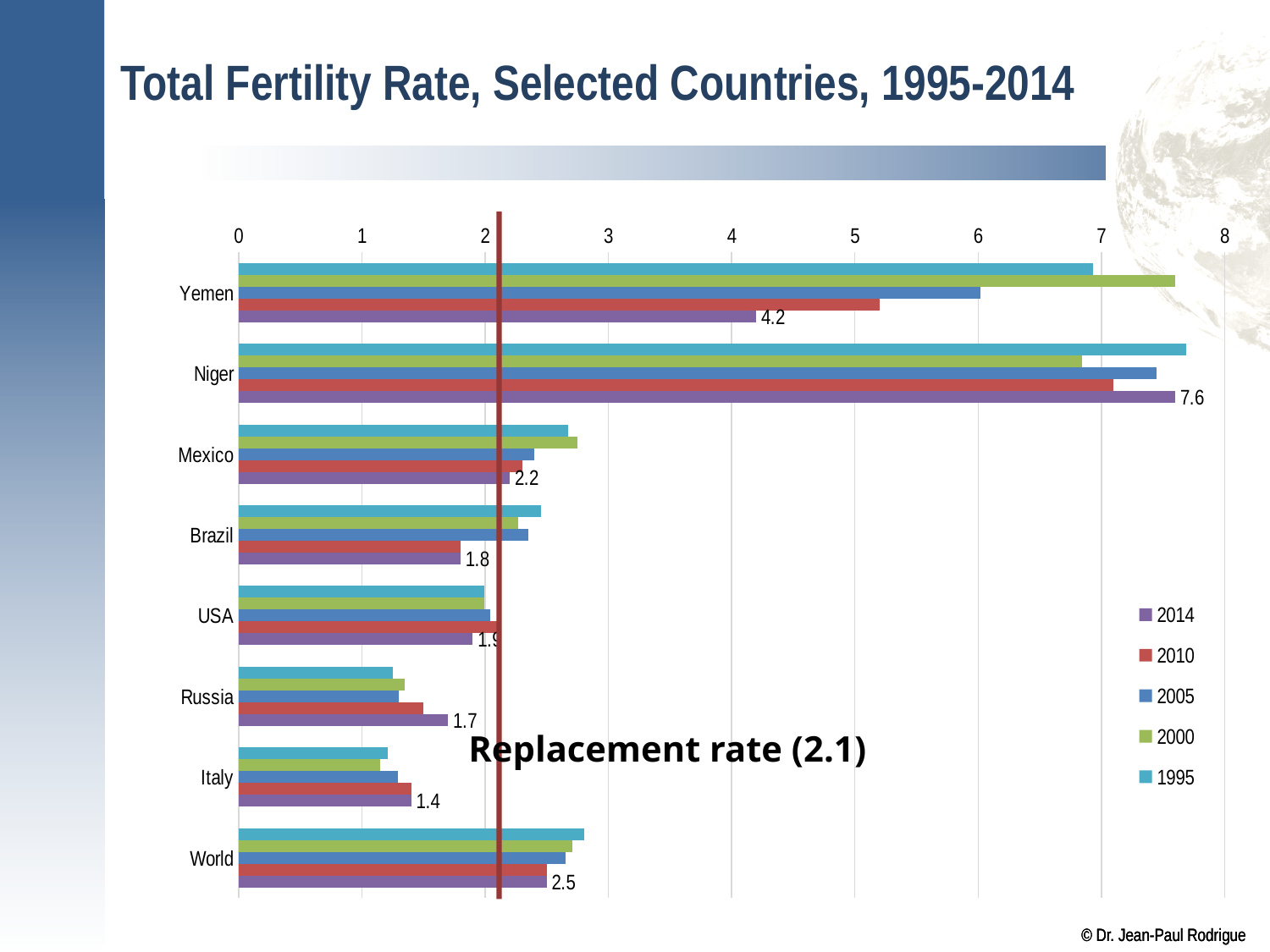
What is the total fertility rate for Yemen in 2014? 4.2 How many countries or regions are shown on the chart? 8 Which country has the highest total fertility rate in 2014? Niger How many years does the legend list? 5 Which country has the lowest total fertility rate in 2014? Italy What is the total fertility rate for Niger in 2014? 7.6 Which is larger in 2014, the value for Mexico or the value for Brazil? Mexico What is the 2014 value for the World? 2.5 What is the difference between the 2014 values for Niger and Yemen? 3.4 Is the 1995 value for Yemen greater or less than 6? greater Is the 1995 value for Russia greater or less than 2? less What kind of chart is shown on the slide? bar chart